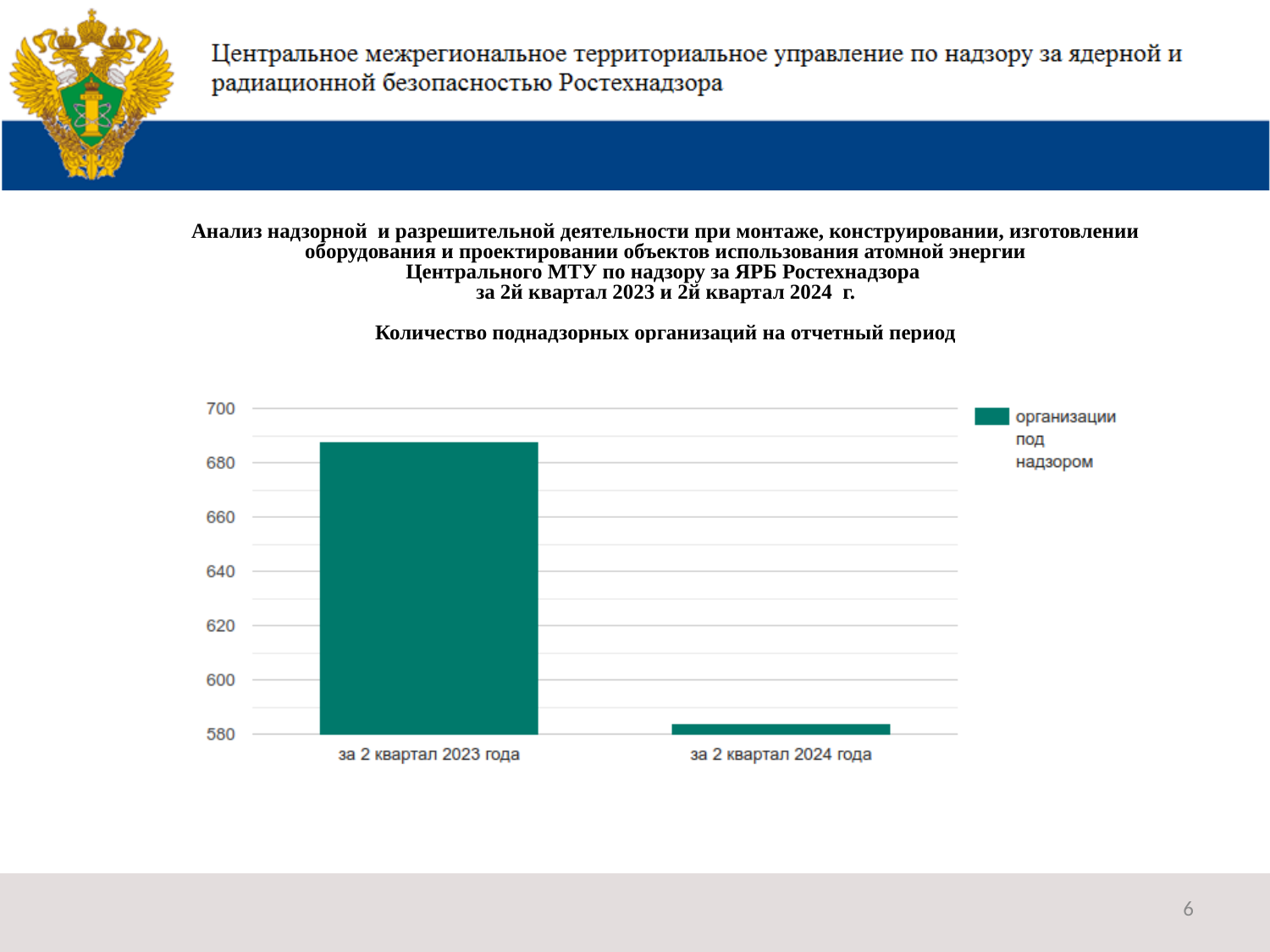
Is the value for за 2 квартал 2024 года greater or less than 600? less Which category has the lowest value in the chart? за 2 квартал 2024 года Which category has the highest value in the chart? за 2 квартал 2023 года What is the title of the chart? Количество поднадзорных организаций на отчетный период How many categories are plotted on the x axis of the chart? 2 What series name is shown in the chart legend? организации под надзором Is the value for за 2 квартал 2023 года greater or less than 680? greater What kind of chart is shown on the slide? bar chart Which is larger: the value for за 2 квартал 2023 года or the value for за 2 квартал 2024 года? за 2 квартал 2023 года Do the values rise or fall from за 2 квартал 2023 года to за 2 квартал 2024 года? fall Is the value for за 2 квартал 2023 года greater or less than 700? less How many series does the chart legend list? 1